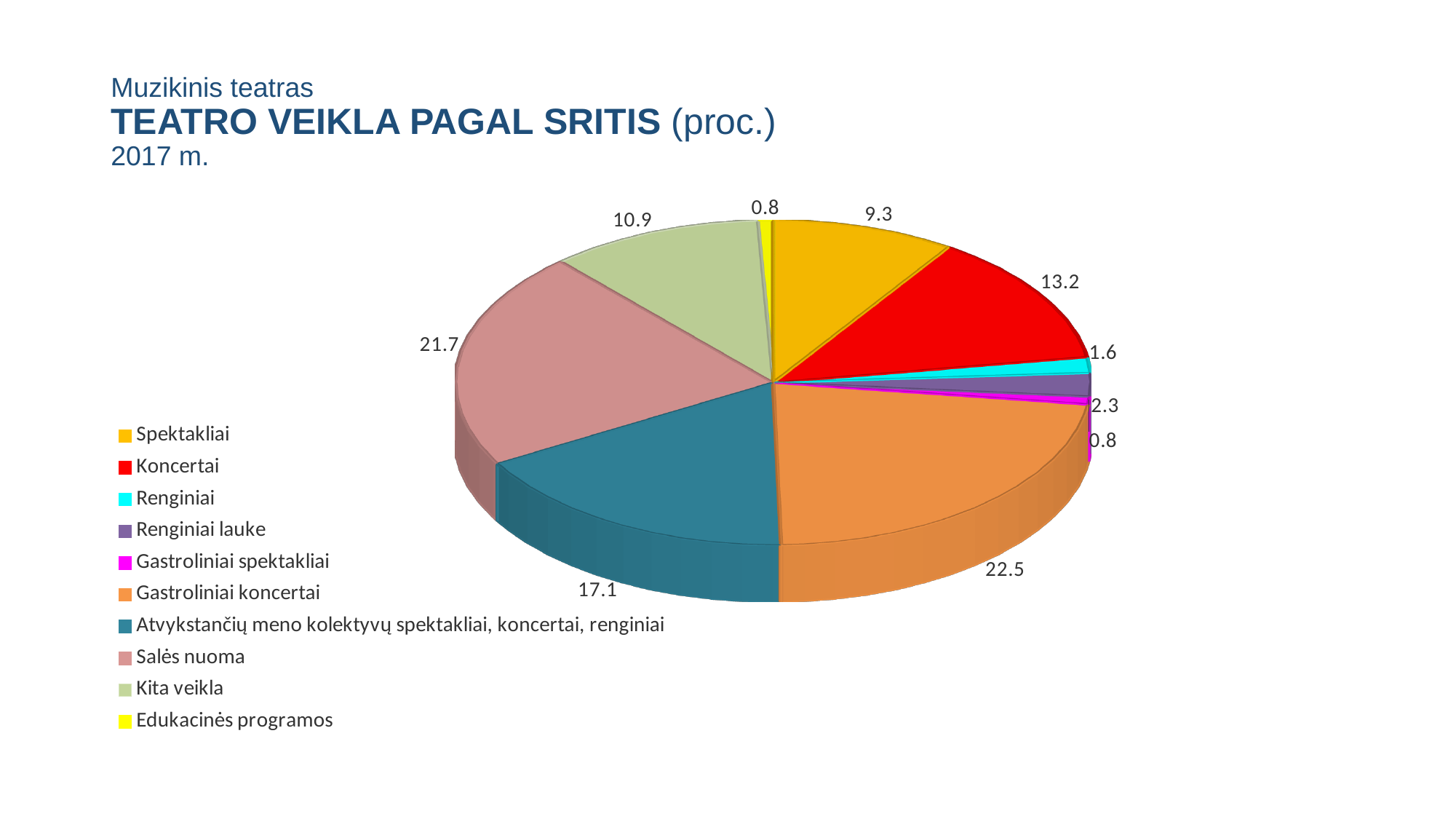
What is the value for Salės nuoma? 21.7 What is the value for Kita veikla? 10.9 What type of chart is shown on the slide? pie chart How many categories does the legend list? 10 What is the value for Gastroliniai koncertai? 22.5 What is the difference between the values for Gastroliniai koncertai and Salės nuoma? 0.8 What is the value for Renginiai lauke? 2.3 Which category has the largest share of the pie? Gastroliniai koncertai Which is larger, the value for Atvykstančių meno kolektyvų spektakliai, koncertai, renginiai or the value for Kita veikla? Atvykstančių meno kolektyvų spektakliai, koncertai, renginiai What is the difference between the values for Koncertai and Spektakliai? 3.9 Which year does the chart title refer to? 2017 m. What is the value for Koncertai? 13.2